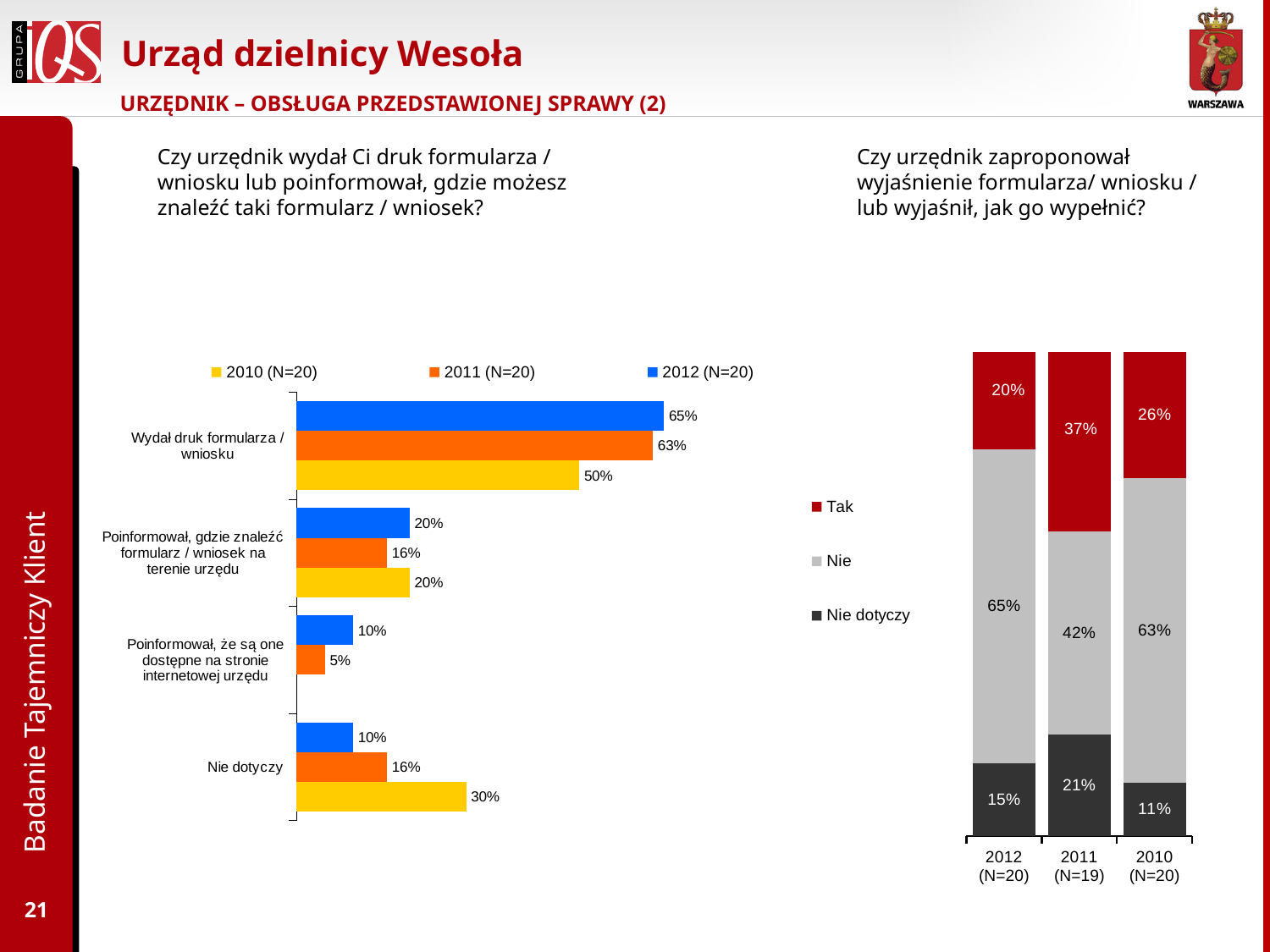
In the left chart, what is the value for 2010 (N=20) for 'Nie dotyczy'? 30% In the right chart, what is the 'Nie dotyczy' share for 2010 (N=20)? 11% In the left chart, what is the value for 2012 (N=20) for 'Wydał druk formularza / wniosku'? 65% In the right chart, is the 'Nie' share for 2012 (N=20) larger or smaller than the 'Nie' share for 2011 (N=19)? Larger In the left chart, what is the value for 2011 (N=20) for 'Poinformował, że są one dostępne na stronie internetowej urzędu'? 5% In the left chart, which category has the highest value for 2011 (N=20)? Wydał druk formularza / wniosku In the right chart, how many bars are shown? 3 In the left chart, how many series does the legend list? 3 What kind of chart is the left chart? Bar chart In the left chart, what is the difference between the 2012 (N=20) and 2010 (N=20) values for 'Wydał druk formularza / wniosku'? 15% In the right chart, what is the 'Tak' share for 2011 (N=19)? 37% In the right chart, which year has the highest 'Nie' share? 2012 (N=20)